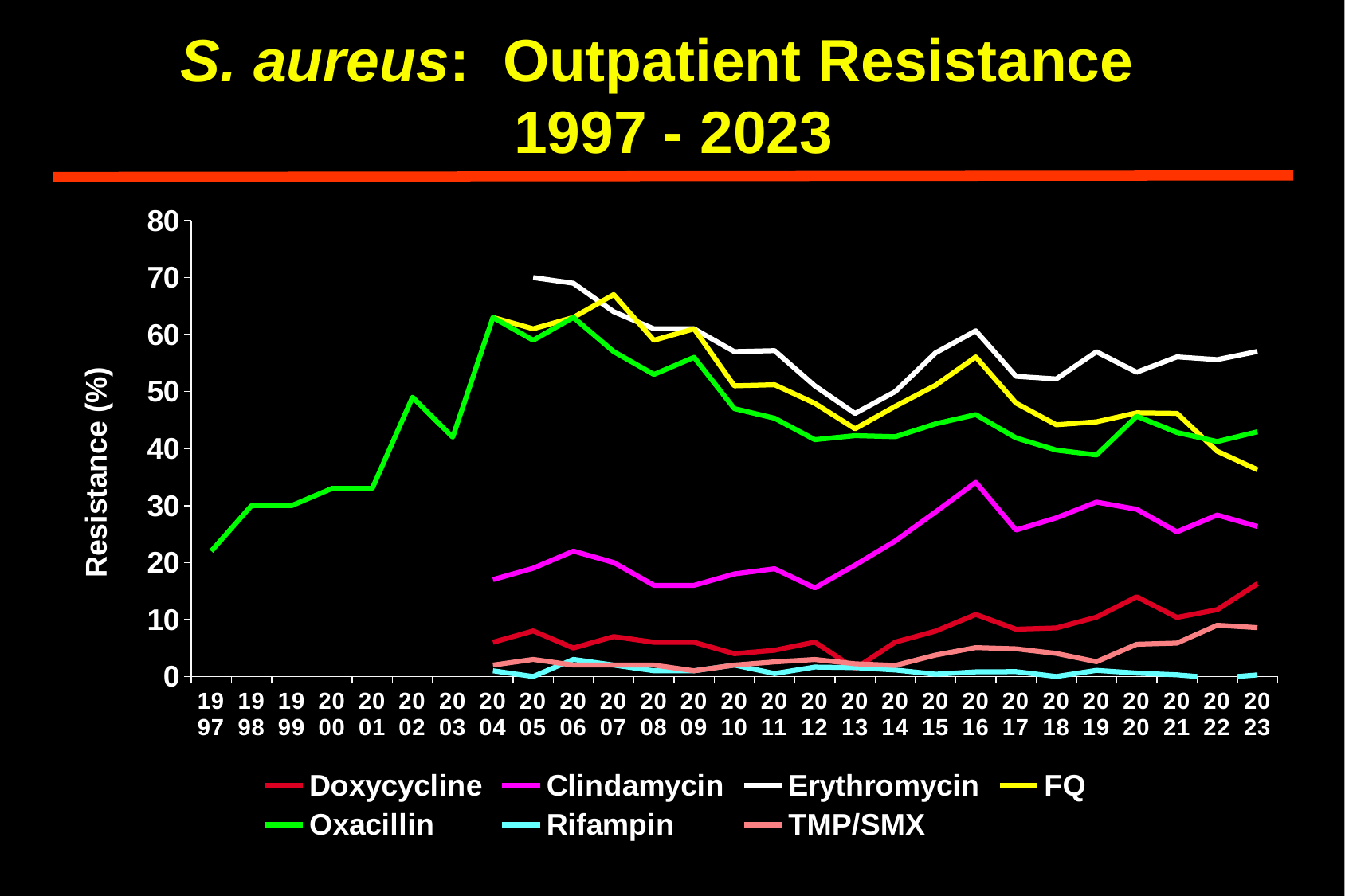
Is the Oxacillin resistance value for 2002 greater or less than 40? greater What is the label on the y axis? Resistance (%) Is the Erythromycin resistance value for 2005 greater or less than 60? greater How many years are shown along the x axis? 27 Which series has the highest resistance value in 2005? Erythromycin How many series does the legend list? 7 Which series has the lowest resistance value in 2023? Rifampin Is the Oxacillin resistance value for 1997 greater or less than 30? less What kind of chart is shown on the slide? line chart In 2023, which series has the higher resistance value, Erythromycin or Oxacillin? Erythromycin In 2023, which series has the higher resistance value, FQ or Oxacillin? Oxacillin Does the Oxacillin resistance value rise or fall from 1997 to 2004? rise